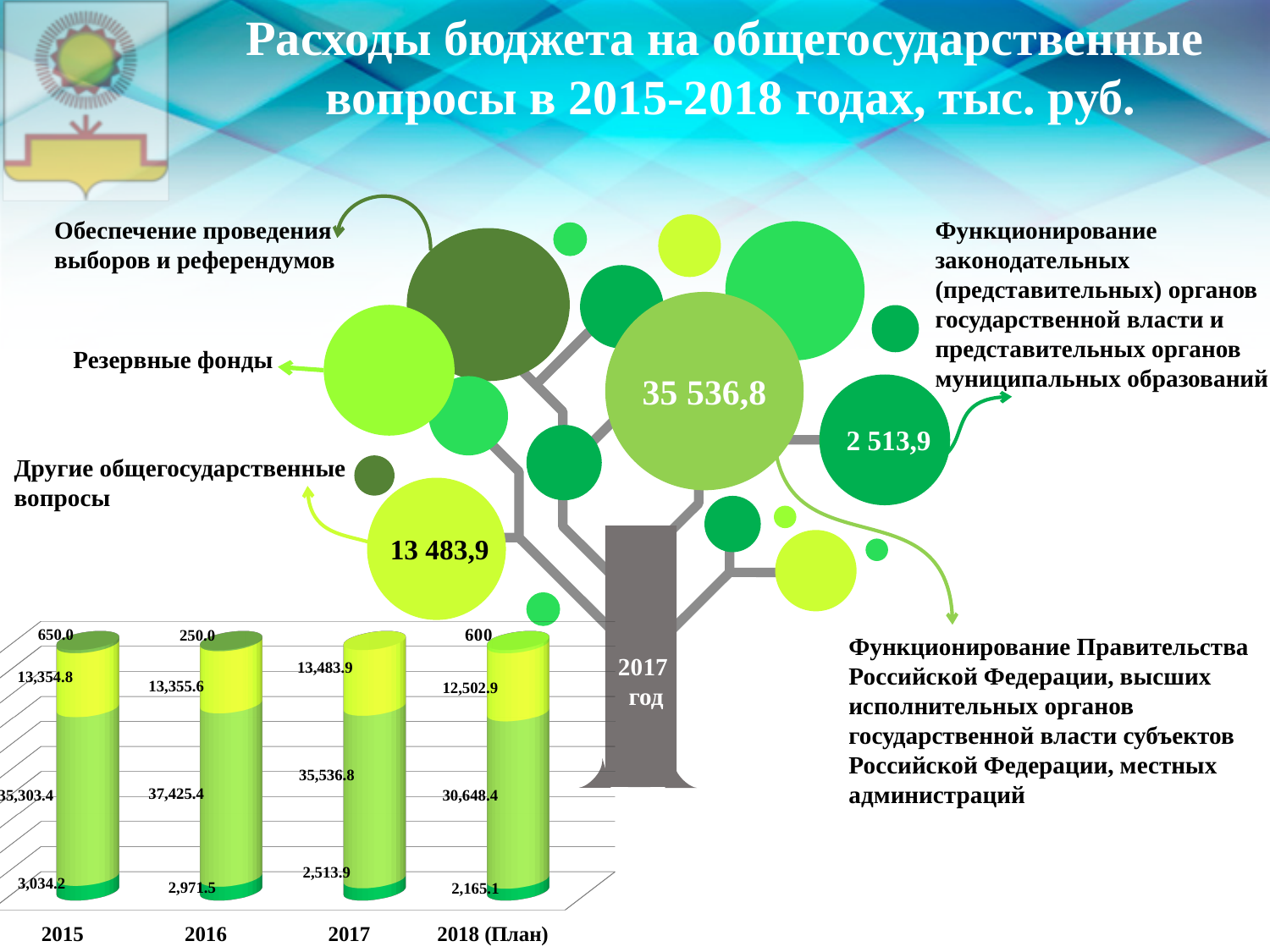
In the bar chart, do the bottom segment values rise or fall from 2015 to 2018 (План)? fall How many years (categories) are shown on the x axis of the bar chart? 4 In the bar chart, which year has the highest value for the middle segment? 2016 What kind of chart is shown at the bottom left of the slide? bar chart In the bar chart, what is the value of the largest (middle) segment of the 2016 bar? 37,425.4 In the bar chart, which year has the lowest value for the bottom segment? 2018 (План) In the bar chart, what is the difference between the middle segment values for 2016 and 2017? 1,888.6 What is the title of the slide? Расходы бюджета на общегосударственные вопросы в 2015-2018 годах, тыс. руб. According to the tree diagram, what is the 2017 value for Функционирование законодательных (представительных) органов государственной власти? 2 513,9 In the bar chart, what is the value of the small top segment of the 2015 bar? 650.0 In the bar chart, what is the value of the bottom segment of the 2018 (План) bar? 2,165.1 In the bar chart, which is larger: the upper (yellow-green) segment for 2017 or for 2018 (План)? 2017